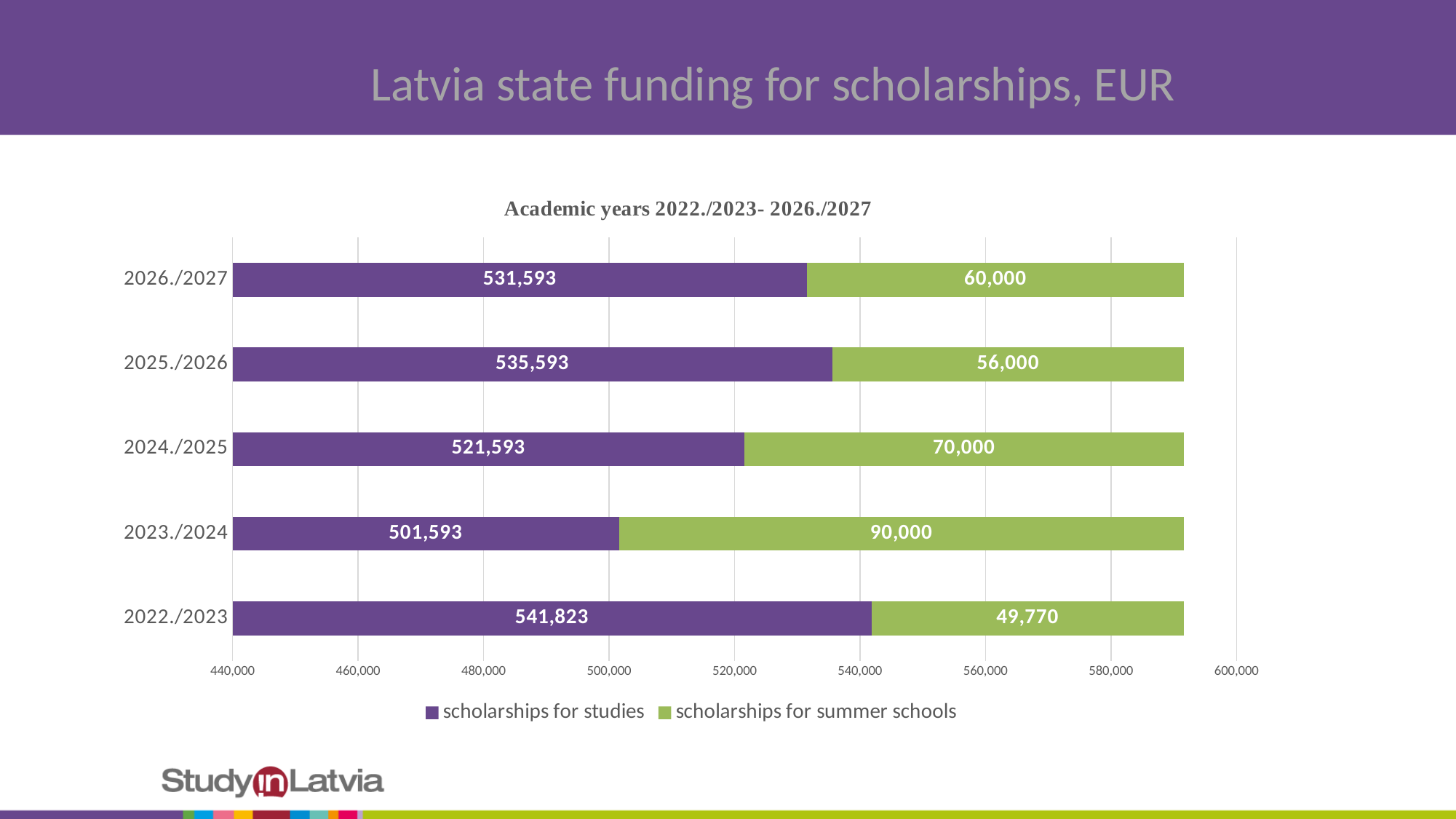
Which is larger: scholarships for studies in 2024./2025 or in 2023./2024? 2024./2025 Which academic year has the highest value for scholarships for summer schools? 2023./2024 What is the total of the stacked bar for 2023./2024? 591,593 What is the value for scholarships for studies in 2022./2023? 541,823 What is the value for scholarships for summer schools in 2024./2025? 70,000 What kind of chart is shown on the slide? Stacked bar chart How many academic years are shown on the chart? 5 What is the difference between scholarships for summer schools in 2023./2024 and 2022./2023? 40,230 How many series does the legend list? 2 What is the difference between scholarships for studies in 2025./2026 and 2026./2027? 4,000 Which academic year has the highest value for scholarships for studies? 2022./2023 Which academic year has the lowest value for scholarships for summer schools? 2022./2023